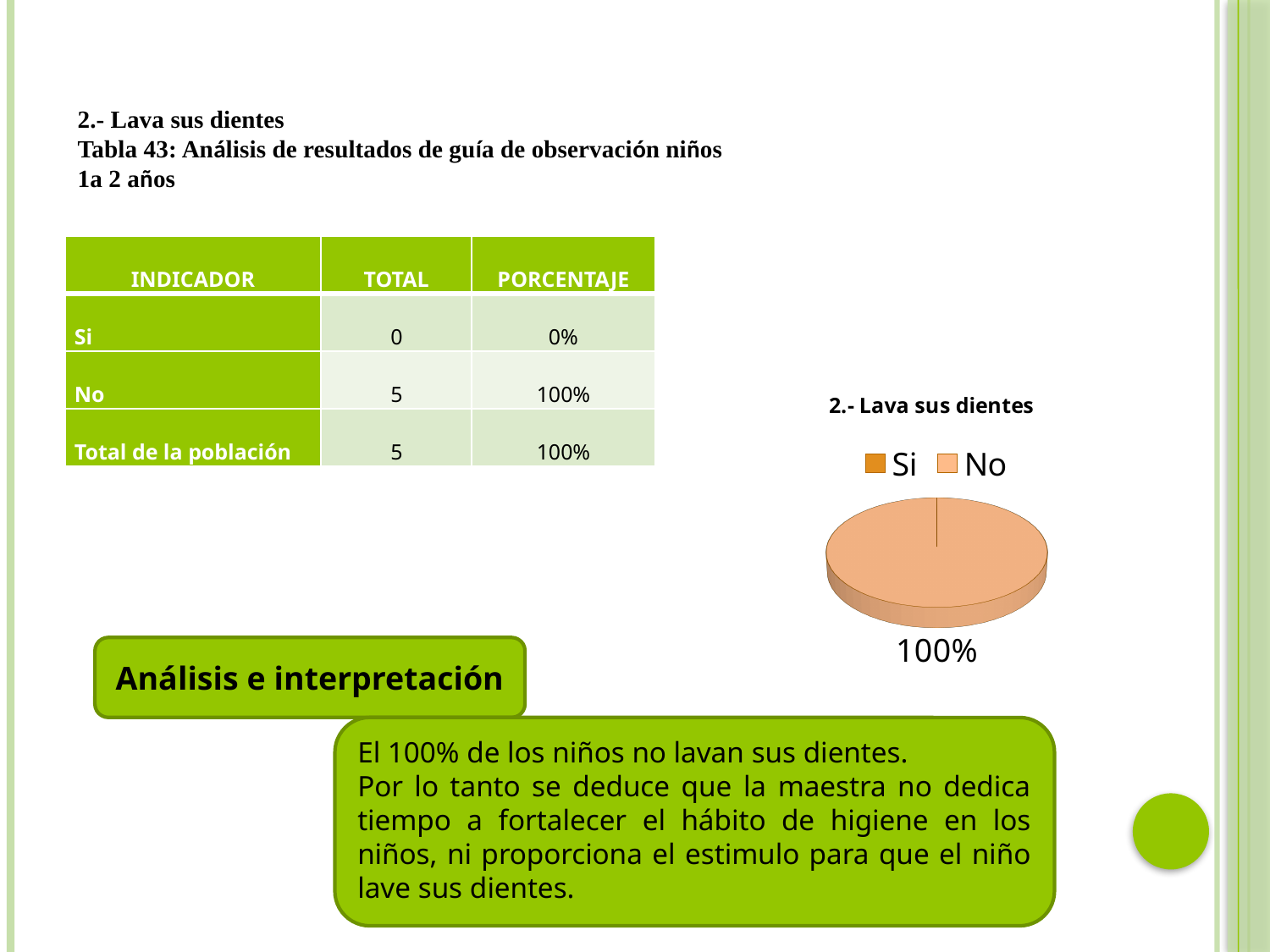
What share of the pie does the 'No' slice represent? 100% What percentage is shown as the data label on the pie chart? 100% Which category has the smallest share of the pie? Si Which category takes up the whole pie? No Which is larger in the pie chart, the 'Si' slice or the 'No' slice? No What kind of chart is shown on the slide? pie chart How many entries does the chart legend list? 2 What are the two legend entries of the chart? Si, No What is the title of the chart? 2.- Lava sus dientes